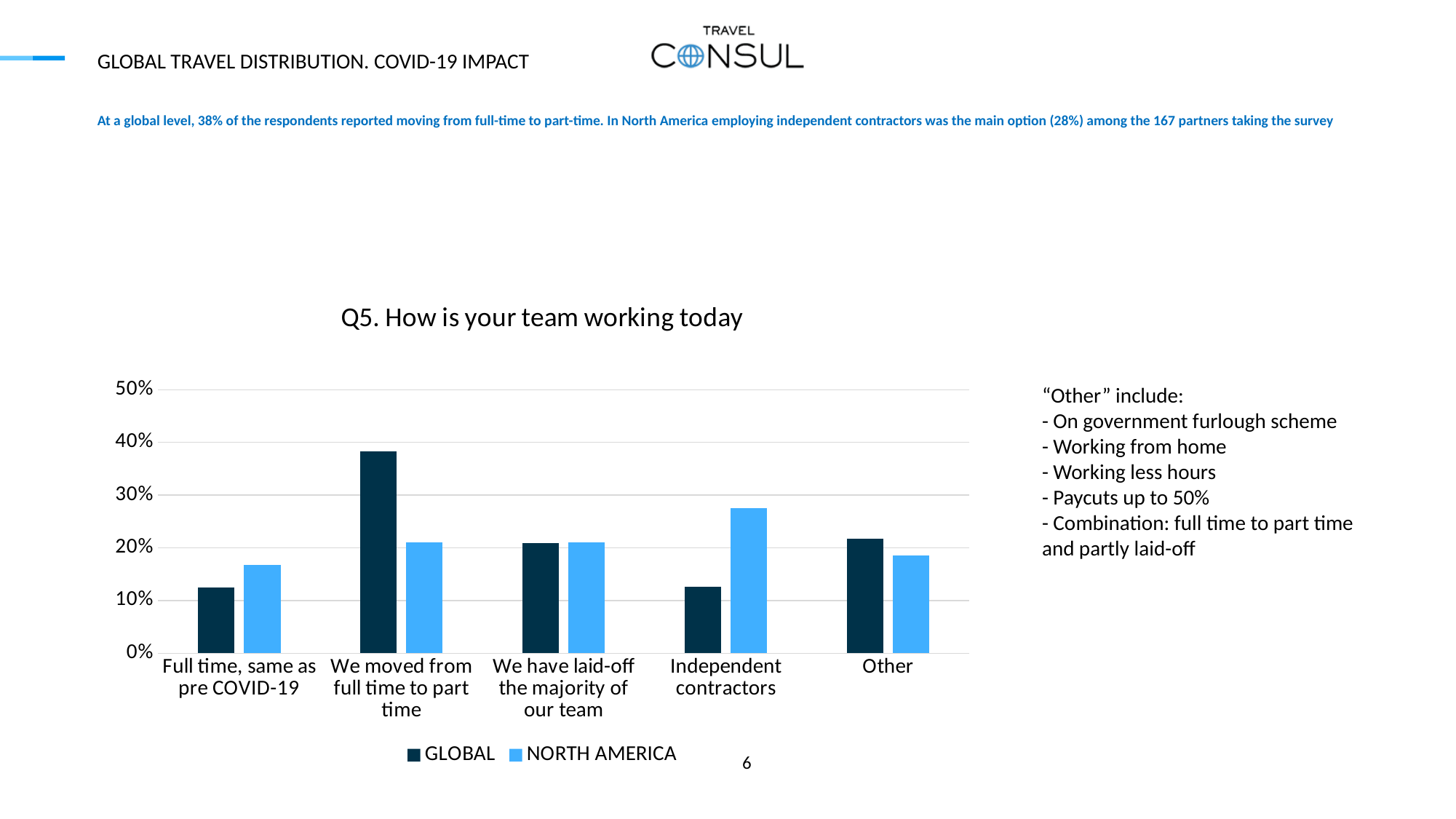
How many series does the legend list? 2 What is the title of the chart? Q5. How is your team working today For 'Full time, same as pre COVID-19', which series has the larger value, GLOBAL or NORTH AMERICA? NORTH AMERICA How many categories are shown on the x axis? 5 For 'We moved from full time to part time', which series has the larger value, GLOBAL or NORTH AMERICA? GLOBAL Is the GLOBAL value for 'We moved from full time to part time' greater or less than 30%? greater Is the NORTH AMERICA value for 'Independent contractors' greater or less than 20%? greater Which category has the highest GLOBAL value? We moved from full time to part time What kind of chart is shown on the slide? bar chart Is the GLOBAL value for 'Full time, same as pre COVID-19' greater or less than 20%? less Which category has the highest NORTH AMERICA value? Independent contractors For 'Independent contractors', which series has the larger value, GLOBAL or NORTH AMERICA? NORTH AMERICA